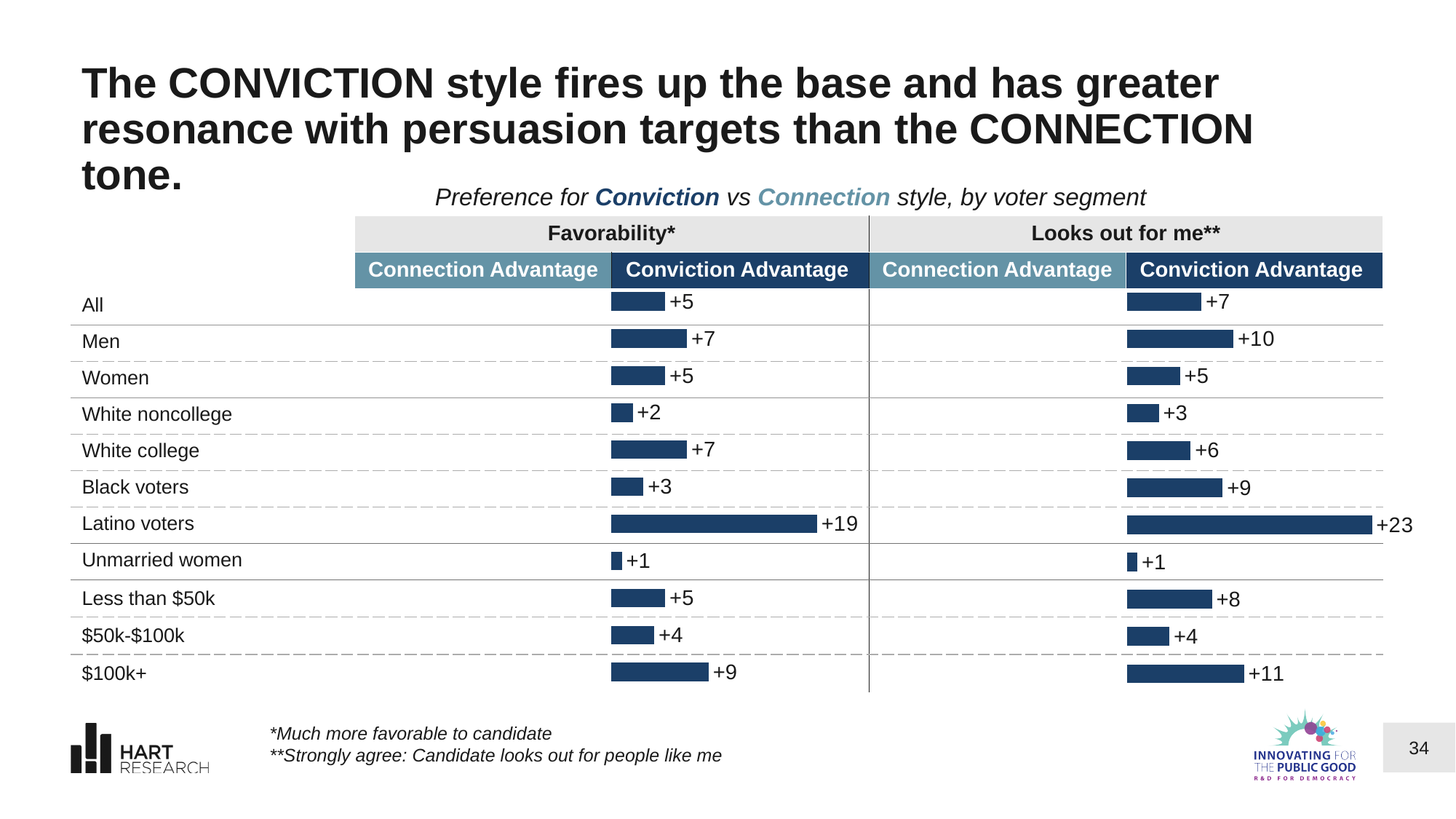
In the Favorability chart, what is the difference between the values for $100k+ and $50k-$100k? 5 What is the subtitle printed above the two charts? Preference for Conviction vs Connection style, by voter segment In the Favorability chart, which is larger, the value for Men or the value for Black voters? Men In the Looks out for me chart, which voter segment has the lowest Conviction advantage? Unmarried women In the Looks out for me chart, what is the value for $100k+? +11 In the Looks out for me chart, what is the difference between the values for Latino voters and Black voters? 14 In the Favorability chart, what is the Conviction advantage for Latino voters? +19 How many voter segments are shown in the Favorability chart? 11 In the Favorability chart, which voter segment has the highest Conviction advantage? Latino voters In the Looks out for me chart, what is the Conviction advantage for Men? +10 In the Looks out for me chart, which is larger, the value for Less than $50k or the value for White college? Less than $50k What type of chart is used to show the Conviction advantage values? Bar chart